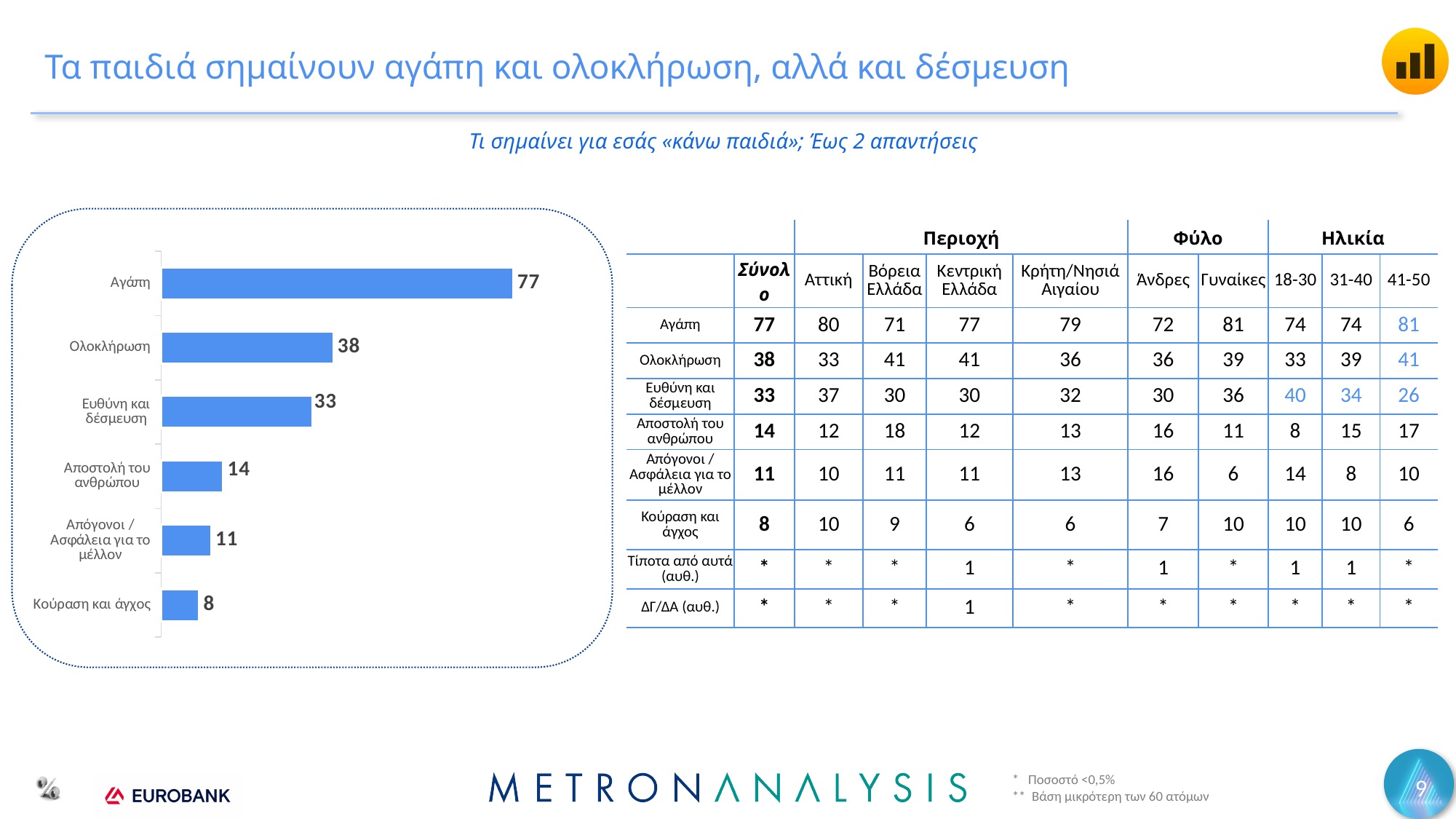
What type of chart is shown on the left of the slide? Bar chart What is the value for Κούραση και άγχος in the bar chart? 8 What colour are the bars in the bar chart? Blue What is the value for Αγάπη in the bar chart? 77 How many categories are shown in the bar chart? 6 What is the difference between the values for Αγάπη and Ολοκλήρωση in the bar chart? 39 Which category has the highest value in the bar chart? Αγάπη What is the value for Ευθύνη και δέσμευση in the bar chart? 33 Which is larger in the bar chart: Ολοκλήρωση or Ευθύνη και δέσμευση? Ολοκλήρωση What is the value for Ολοκλήρωση in the bar chart? 38 What is the difference between the values for Αποστολή του ανθρώπου and Απόγονοι / Ασφάλεια για το μέλλον in the bar chart? 3 Which category has the lowest value in the bar chart? Κούραση και άγχος